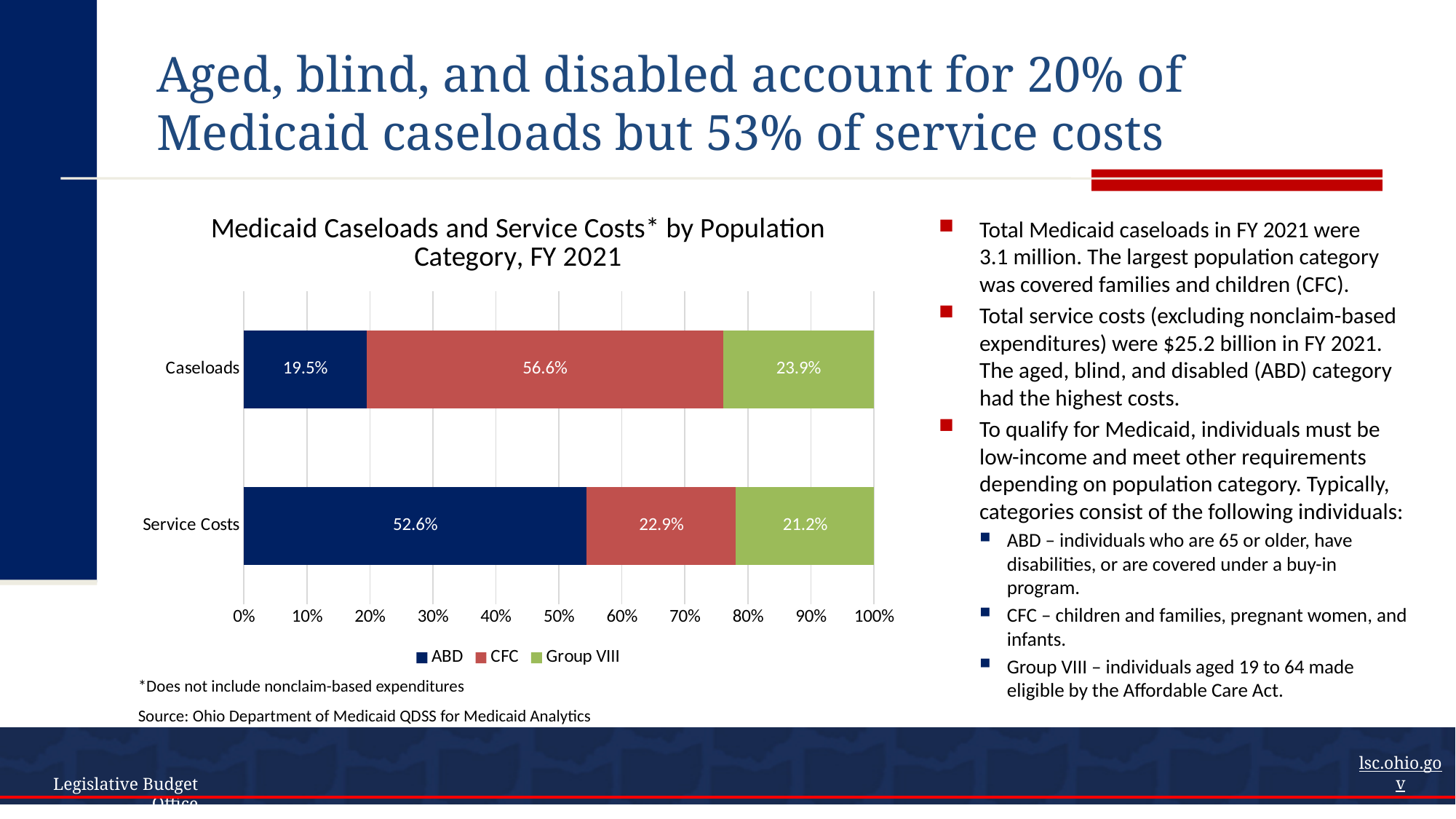
What is the Group VIII share of Caseloads? 23.9% What is the title of the chart? Medicaid Caseloads and Service Costs* by Population Category, FY 2021 Which population category has the largest share of Caseloads? CFC What is the CFC share of Service Costs? 22.9% Which is larger: the CFC share of Caseloads or the CFC share of Service Costs? CFC share of Caseloads What is the ABD share of Caseloads? 19.5% How many series does the legend list? 3 Which population category has the smallest share of Service Costs? Group VIII What kind of chart is shown on the slide? Stacked bar chart What is the difference between the ABD share of Service Costs and the ABD share of Caseloads? 33.1 percentage points What is the ABD share of Service Costs? 52.6% How many categories are shown on the vertical axis? 2